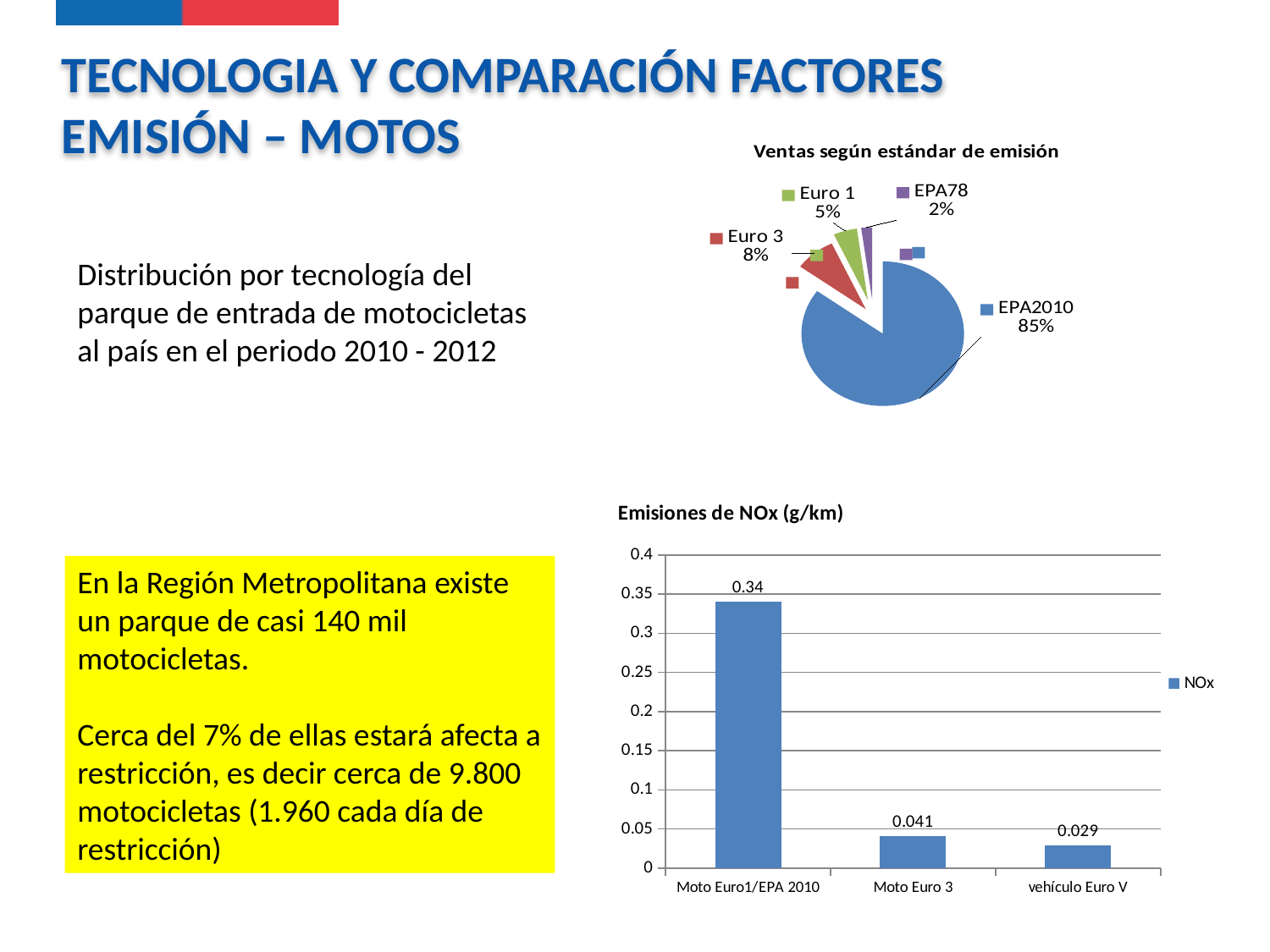
In the 'Ventas según estándar de emisión' chart, which category has the smallest share? EPA78 In the 'Emisiones de NOx (g/km)' chart, what is the difference between Moto Euro1/EPA 2010 and Moto Euro 3? 0.299 In the 'Ventas según estándar de emisión' chart, how many slices does the pie have? 4 In the 'Emisiones de NOx (g/km)' chart, which category has the highest value? Moto Euro1/EPA 2010 In the 'Emisiones de NOx (g/km)' chart, what is the value for vehículo Euro V? 0.029 In the 'Emisiones de NOx (g/km)' chart, what is the value for Moto Euro 3? 0.041 In the 'Ventas según estándar de emisión' chart, what is the difference between the Euro 1 share and the EPA78 share? 3% In the 'Emisiones de NOx (g/km)' chart, is the value for Moto Euro1/EPA 2010 greater or less than 0.3? greater What kind of chart is 'Ventas según estándar de emisión'? pie chart In the 'Ventas según estándar de emisión' chart, what share does Euro 3 have? 8% What kind of chart is 'Emisiones de NOx (g/km)'? bar chart In the 'Ventas según estándar de emisión' chart, what share does EPA2010 have? 85%